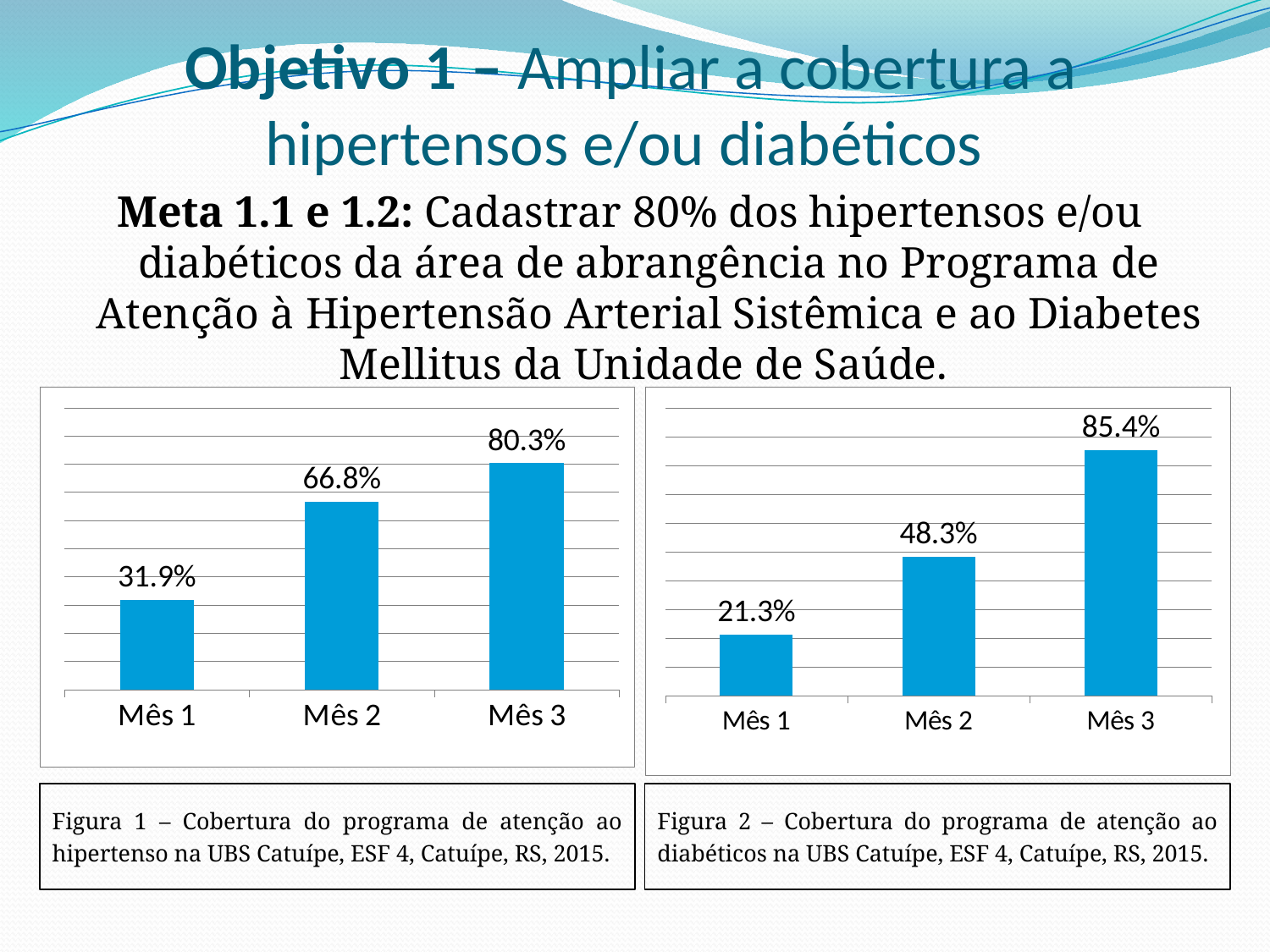
How many categories (months) are shown in the left chart (Figura 1)? 3 In the right chart (Figura 2, diabéticos), which month has the lowest value? Mês 1 Which is larger: Mês 1 in the left chart (Figura 1) or Mês 1 in the right chart (Figura 2)? Mês 1 in the left chart (Figura 1) In the left chart (Figura 1, hipertensos), what is the difference between Mês 3 and Mês 1? 48.4% What kind of chart is the right chart (Figura 2)? Bar chart In the right chart (Figura 2, diabéticos), is the value for Mês 2 greater or less than Mês 3? less In the right chart (Figura 2, diabéticos), what is the difference between Mês 2 and Mês 1? 27.0% In the left chart (Figura 1, hipertensos), do the values rise or fall from Mês 1 to Mês 3? Rise In the left chart (Figura 1, hipertensos), what is the value for Mês 2? 66.8% What is the caption of the right chart? Figura 2 – Cobertura do programa de atenção ao diabéticos na UBS Catuípe, ESF 4, Catuípe, RS, 2015. In the right chart (Figura 2, diabéticos), what is the value for Mês 3? 85.4% In the left chart (Figura 1, hipertensos), which month has the highest value? Mês 3